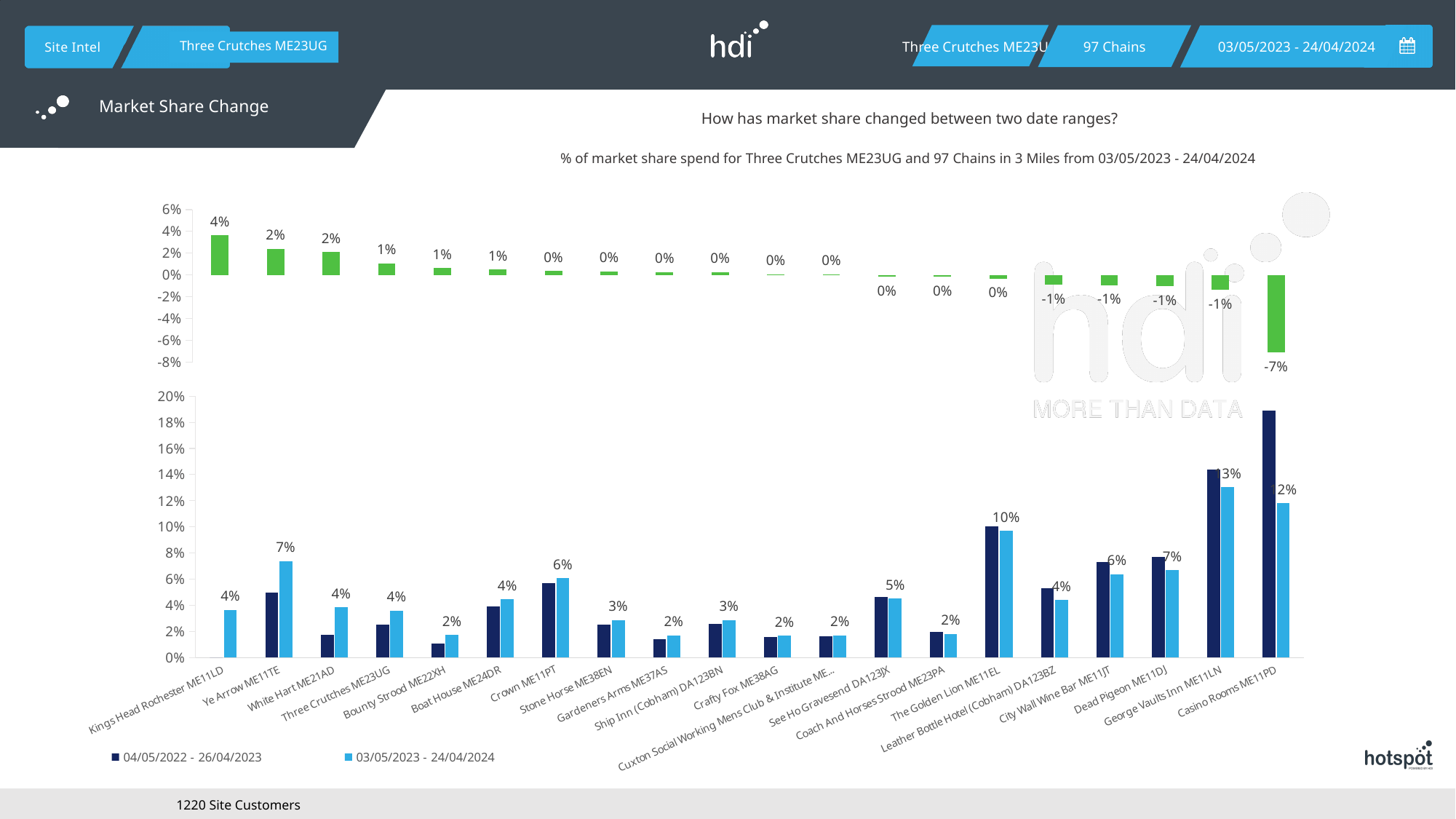
In the top chart (market share change), what is the value for Casino Rooms ME11PD? -7% In the bottom chart, is the 04/05/2022 - 26/04/2023 value for Casino Rooms ME11PD greater or less than 18%? greater What kind of chart is the bottom chart? Bar chart In the top chart (market share change), which category has the highest value? Kings Head Rochester ME11LD In the bottom chart, which category has the highest value in the 03/05/2023 - 24/04/2024 series? George Vaults Inn ME11LN In the bottom chart, how many series does the legend list? 2 In the bottom chart, what is the value for The Golden Lion ME11EL in the 03/05/2023 - 24/04/2024 series? 10% In the bottom chart, what is the difference between Ye Arrow ME11TE and Kings Head Rochester ME11LD in the 03/05/2023 - 24/04/2024 series? 3% How many categories are shown on the x axis of the bottom chart? 20 In the top chart (market share change), what is the value for Kings Head Rochester ME11LD? 4% In the bottom chart, which is larger in the 03/05/2023 - 24/04/2024 series: The Golden Lion ME11EL or Dead Pigeon ME11DJ? The Golden Lion ME11EL In the top chart (market share change), which category has the lowest value? Casino Rooms ME11PD